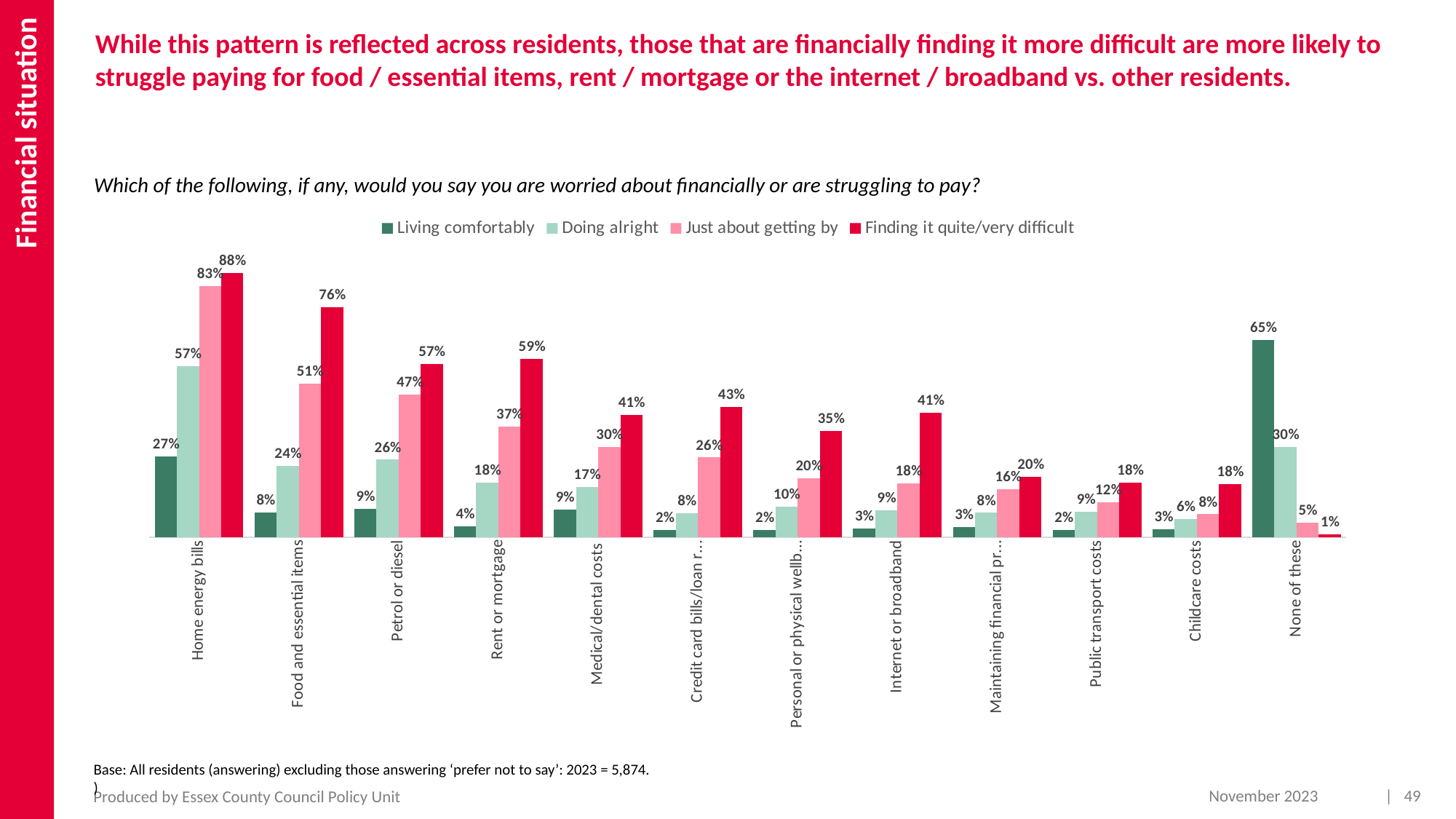
What is the value for 'Finding it quite/very difficult' for Home energy bills? 88% Which series is shown in the darkest green colour in the legend? Living comfortably For Internet or broadband, which is larger: the 'Doing alright' value or the 'Just about getting by' value? Just about getting by What is the value for 'Doing alright' for Petrol or diesel? 26% What is the value for 'Just about getting by' for Rent or mortgage? 37% Which category has the lowest value for 'Finding it quite/very difficult'? None of these What is the value for 'Living comfortably' for None of these? 65% What kind of chart is shown on the slide? Bar chart How many categories are shown along the x axis? 12 What is the difference between the 'Finding it quite/very difficult' and 'Living comfortably' values for Food and essential items? 68 percentage points How many series does the legend list? 4 Which category has the highest value for 'Finding it quite/very difficult'? Home energy bills